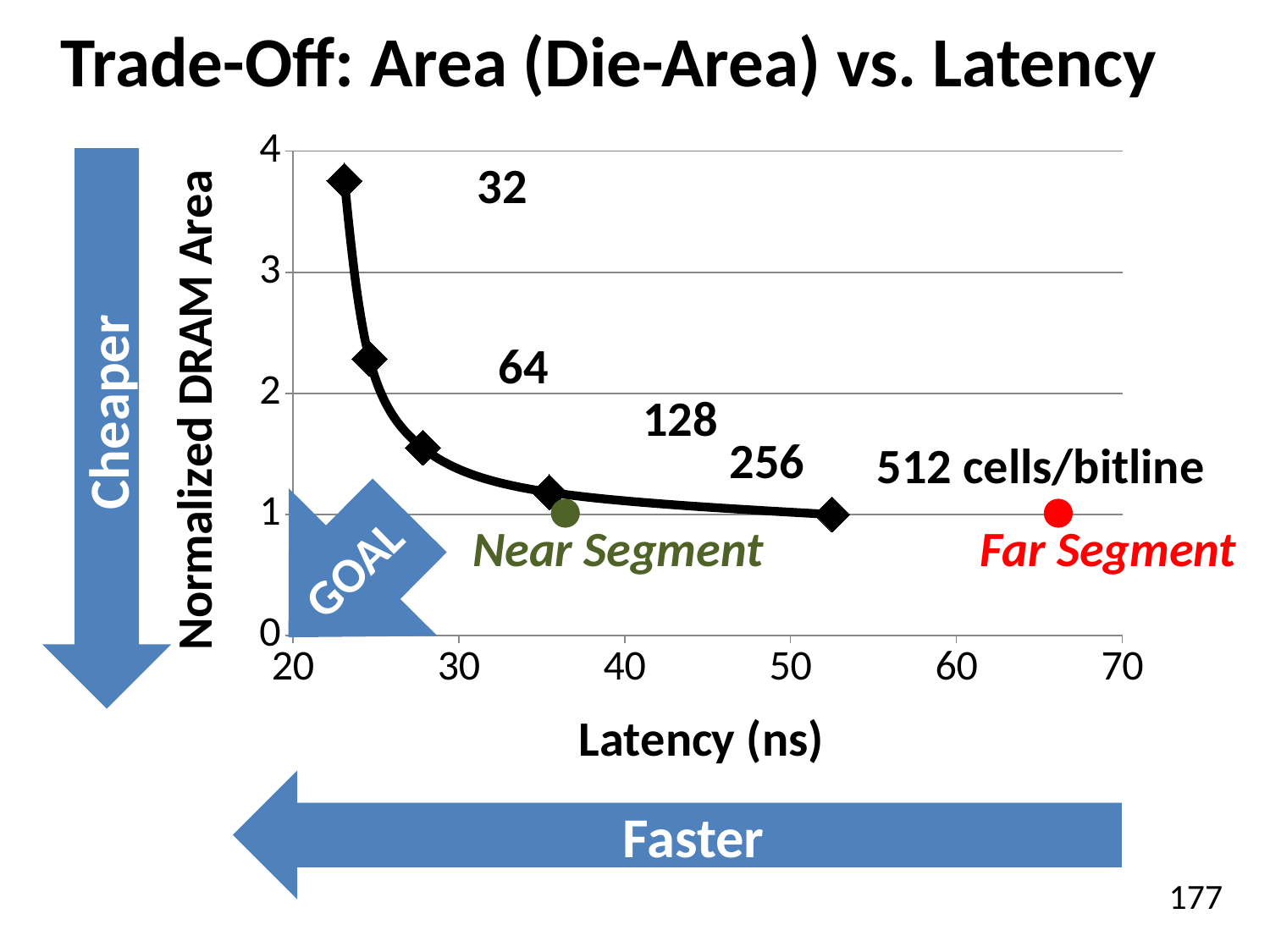
Which has a larger normalized DRAM area, 64 cells/bitline or 128 cells/bitline? 64 cells/bitline Is the normalized DRAM area for 128 cells/bitline greater or less than 2? less Which cells/bitline configuration has the highest normalized DRAM area? 32 Is the latency of the Far Segment point greater or less than 60 ns? greater Is the normalized DRAM area for 64 cells/bitline greater or less than 2? greater As latency increases along the x axis, does the normalized DRAM area rise or fall? fall What is the title of the x axis? Latency (ns) How many cells/bitline configurations are plotted on the black curve? 5 Which cells/bitline configuration has the highest latency? 512 What kind of chart is shown on the slide? line chart